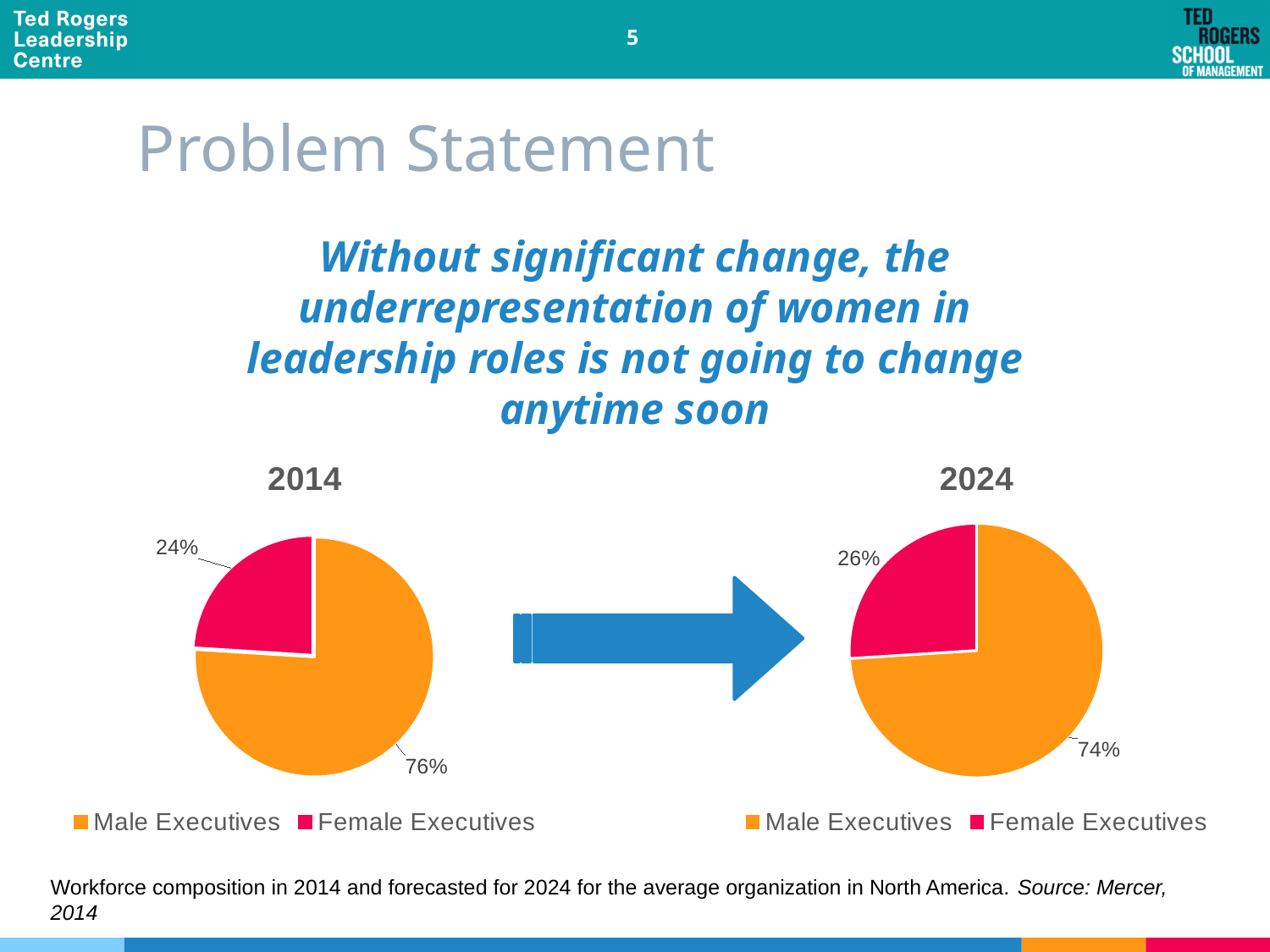
In the 2024 pie chart, which slice is the smallest? Female Executives In the 2014 pie chart, what share is labelled for Male Executives? 76% In the 2014 pie chart, what share is labelled for Female Executives? 24% How many entries does the legend of the 2014 pie chart list? 2 In the 2014 pie chart, which slice is the largest? Male Executives What type of chart is used for the 2014 data? Pie chart In the 2024 pie chart, what colour is the Female Executives slice? Pink/red In the 2024 pie chart, what share is labelled for Female Executives? 26% How many slices does the 2024 pie chart have? 2 Is the Female Executives share larger in the 2014 chart or the 2024 chart? 2024 In the 2024 pie chart, what share is labelled for Male Executives? 74% In the 2014 pie chart, what is the difference between the Male Executives and Female Executives shares? 52%